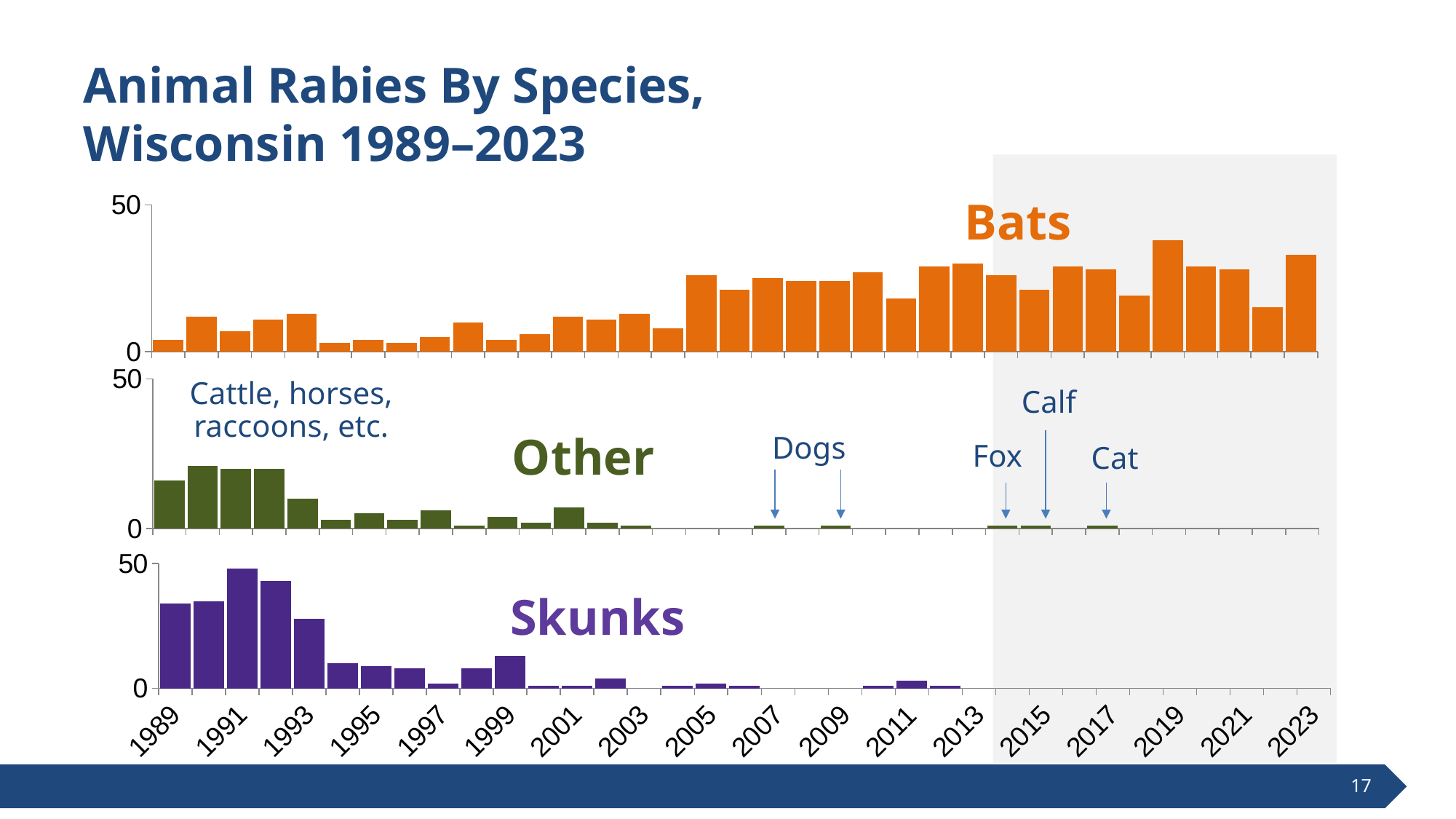
In the Skunks chart, do the values generally rise or fall from 1989 to 2023? Fall In the Bats chart, which year has the highest bar? 2019 In the Bats chart, do the values generally rise or fall from 1989 to 2023? Rise How many separate bar charts are shown on the slide? 3 In the Bats chart, which year has the larger value, 2019 or 2023? 2019 What colour are the bars in the Skunks chart? Purple What is the title of the slide's chart? Animal Rabies By Species, Wisconsin 1989–2023 In the Bats chart, is the value for 2019 greater or less than 50? less In the Skunks chart, which year has the highest bar? 1991 What kind of charts are shown on the slide? Bar charts In the Skunks chart, which year has the larger value, 1989 or 1993? 1989 In the Other chart, which year has the larger value, 1989 or 1993? 1989